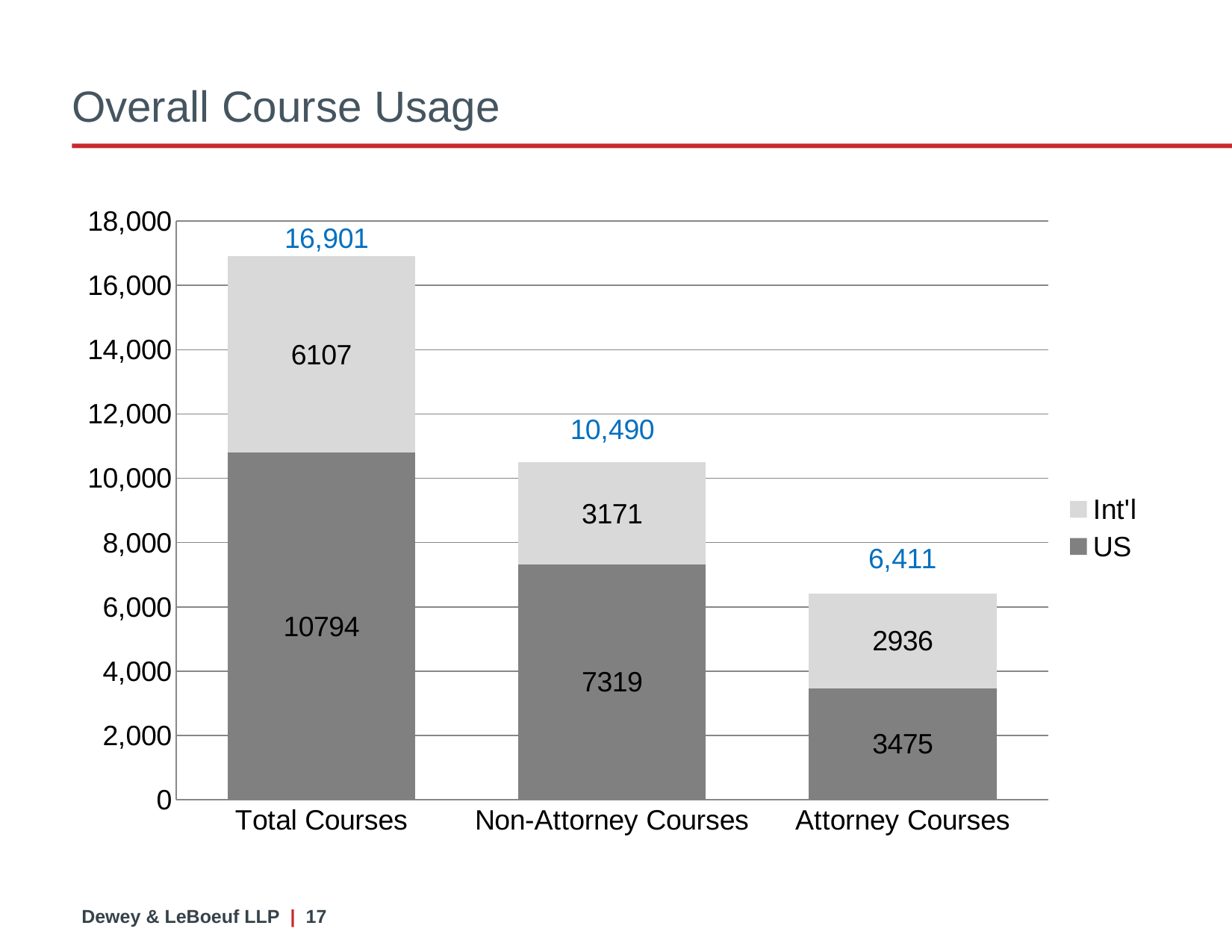
What is the US value for Attorney Courses? 3475 Which is larger for Attorney Courses, the US value or the Int'l value? US How many categories are shown on the x axis? 3 How many series does the legend list? 2 What is the Int'l value for Non-Attorney Courses? 3171 What is the total of the stacked bar for Attorney Courses? 6,411 What kind of chart is shown on the slide? Stacked bar chart What is the total of the stacked bar for Non-Attorney Courses? 10,490 What is the difference between the US value and the Int'l value for Non-Attorney Courses? 4148 What is the Int'l value for Attorney Courses? 2936 What is the US value for Total Courses? 10794 Which category has the lowest stacked total? Attorney Courses